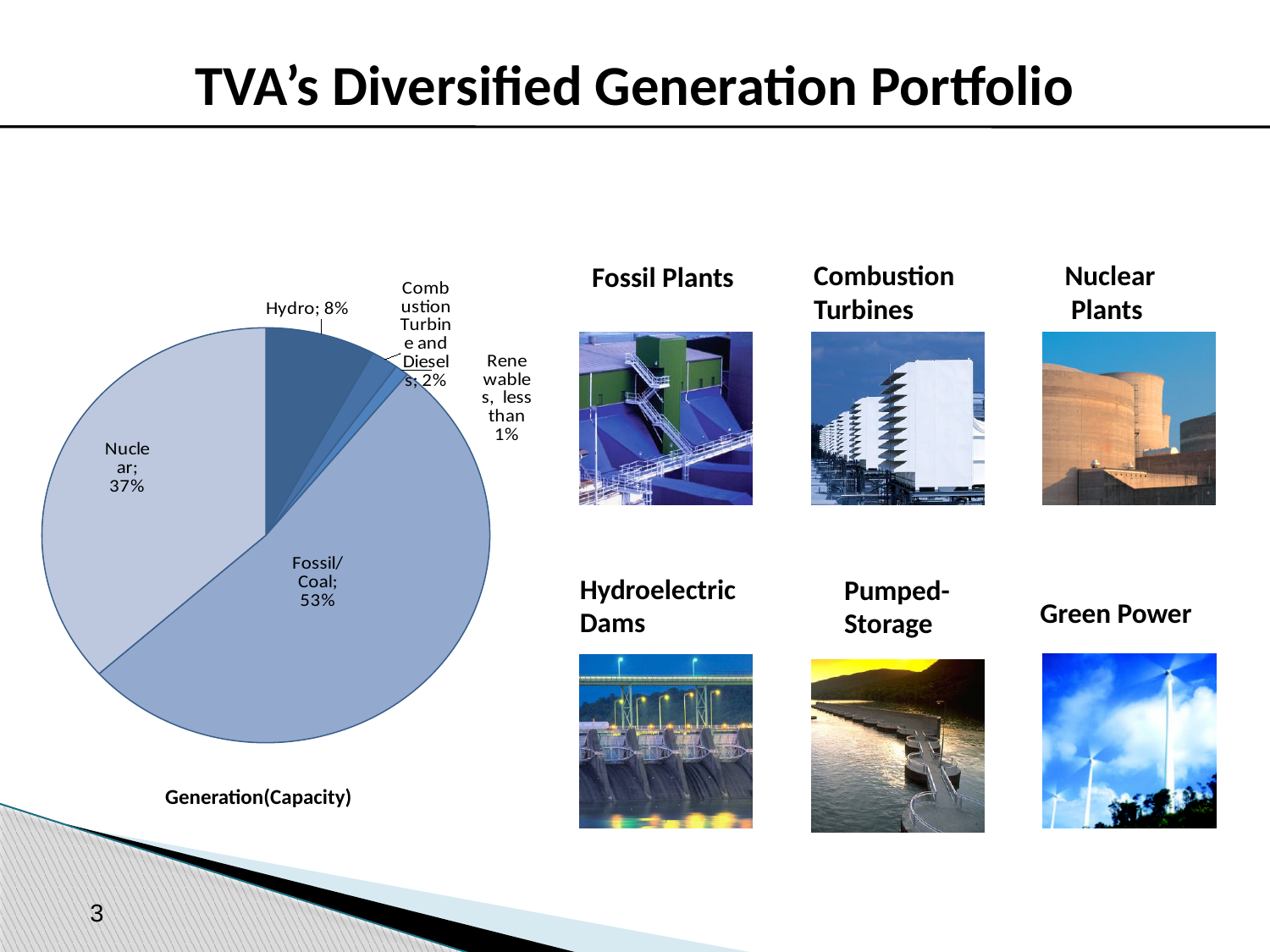
What share of generation capacity is labelled for Renewables? less than 1% Which category has the largest slice of the pie? Fossil/Coal What share of generation capacity does Nuclear account for? 37% What is the title shown beneath the pie chart? Generation(Capacity) What share of generation capacity does Fossil/Coal account for? 53% What share of generation capacity do Combustion Turbine and Diesels account for? 2% What is the difference in percentage points between Fossil/Coal and Nuclear? 16 How many slices does the pie chart have? 5 Which category has the smallest slice of the pie? Renewables What kind of chart is shown on the slide? pie chart Which is larger, the Hydro share or the Combustion Turbine and Diesels share? Hydro What share of generation capacity does Hydro account for? 8%